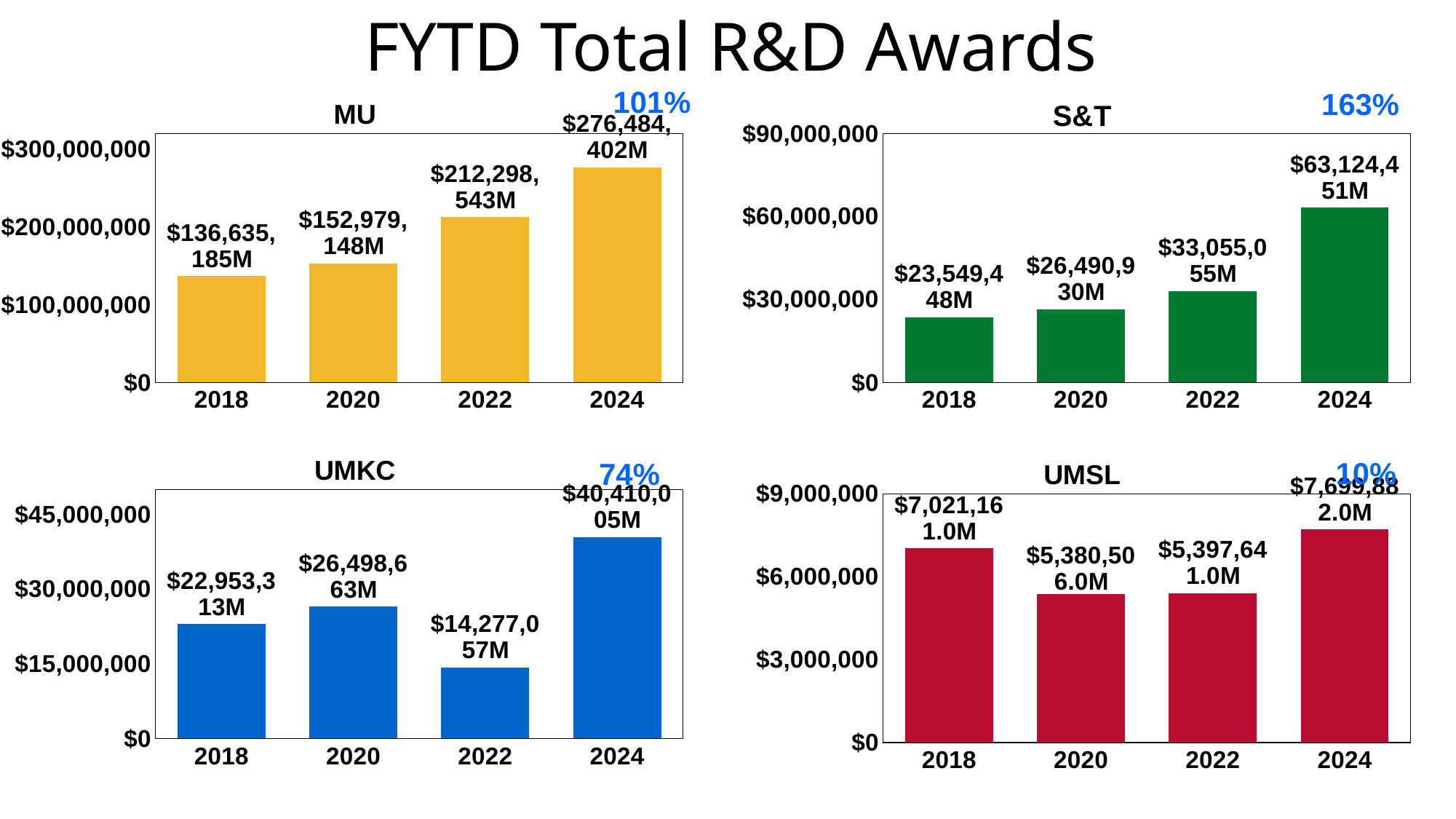
In the UMKC chart, which is larger, the value for 2018 or the value for 2020? 2020 In the UMKC chart, what is the value shown for 2022? $14,277,057M In the S&T chart, what is the value shown for 2024? $63,124,451M In the S&T chart, is the value for 2022 greater or less than $30,000,000? greater In the MU chart, is the value for 2020 greater or less than $200,000,000? less In the UMSL chart, what is the value shown for 2020? $5,380,506.0M What kind of chart is the UMSL chart? bar chart In the MU chart, do the values rise or fall from 2018 to 2024? rise In the S&T chart, which year has the highest value? 2024 How many bars are plotted in the MU chart? 4 In the MU chart, what is the value shown for 2018? $136,635,185M In the UMKC chart, which year has the lowest value? 2022